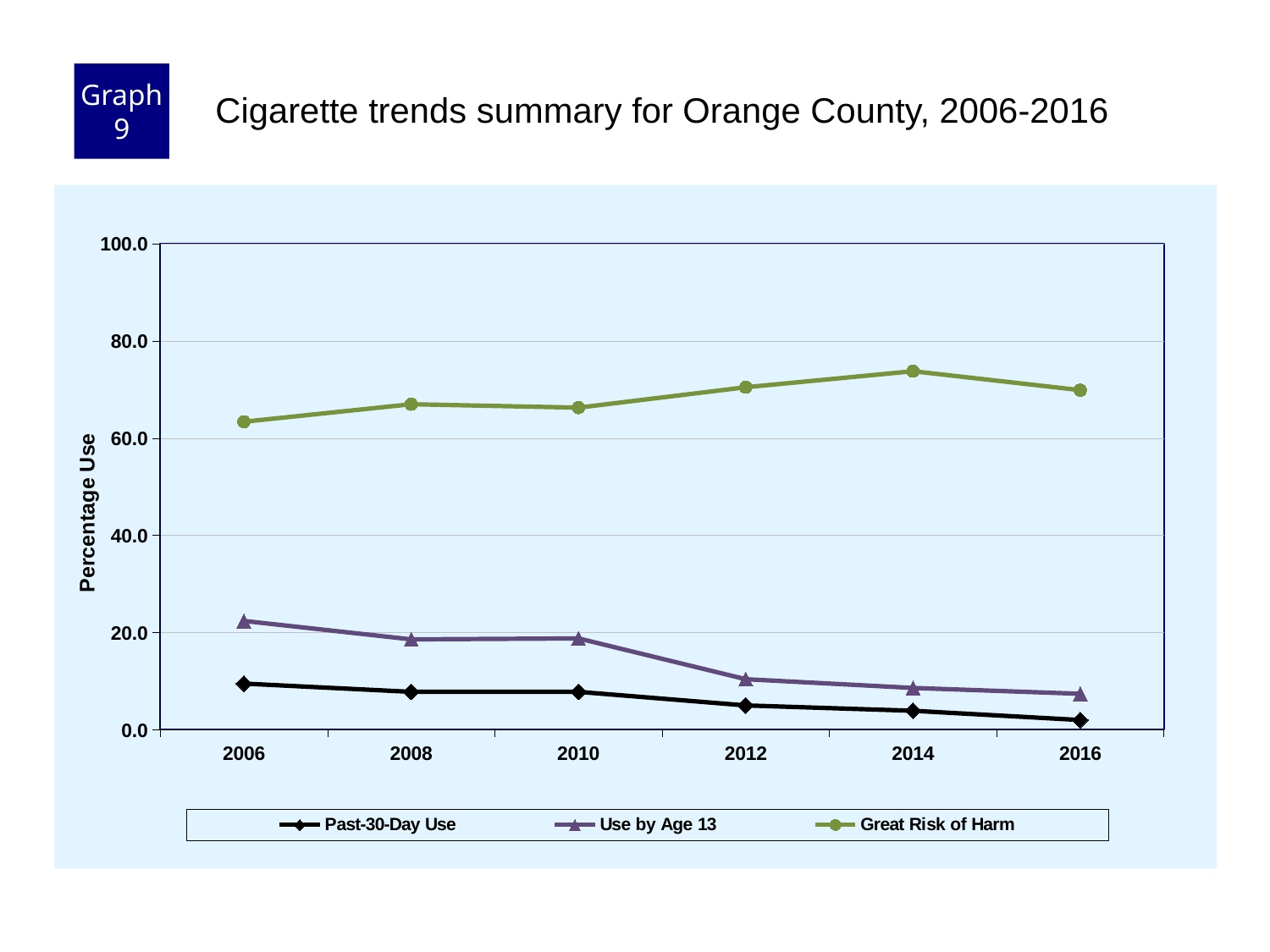
Does the Past-30-Day Use series rise or fall from 2006 to 2016? fall Is the value for Use by Age 13 in 2012 greater or less than 20.0? less How many series does the legend list? 3 In which year is the Use by Age 13 series at its lowest? 2016 In which year is the Great Risk of Harm series at its highest? 2014 In 2006, which is larger: Use by Age 13 or Past-30-Day Use? Use by Age 13 What kind of chart is shown on the slide? line chart What is the label on the y axis? Percentage Use Is the value for Great Risk of Harm in 2006 greater or less than 60.0? greater Is the value for Use by Age 13 in 2006 greater or less than 20.0? greater What is the title of the chart? Cigarette trends summary for Orange County, 2006-2016 How many years are plotted along the x axis? 6